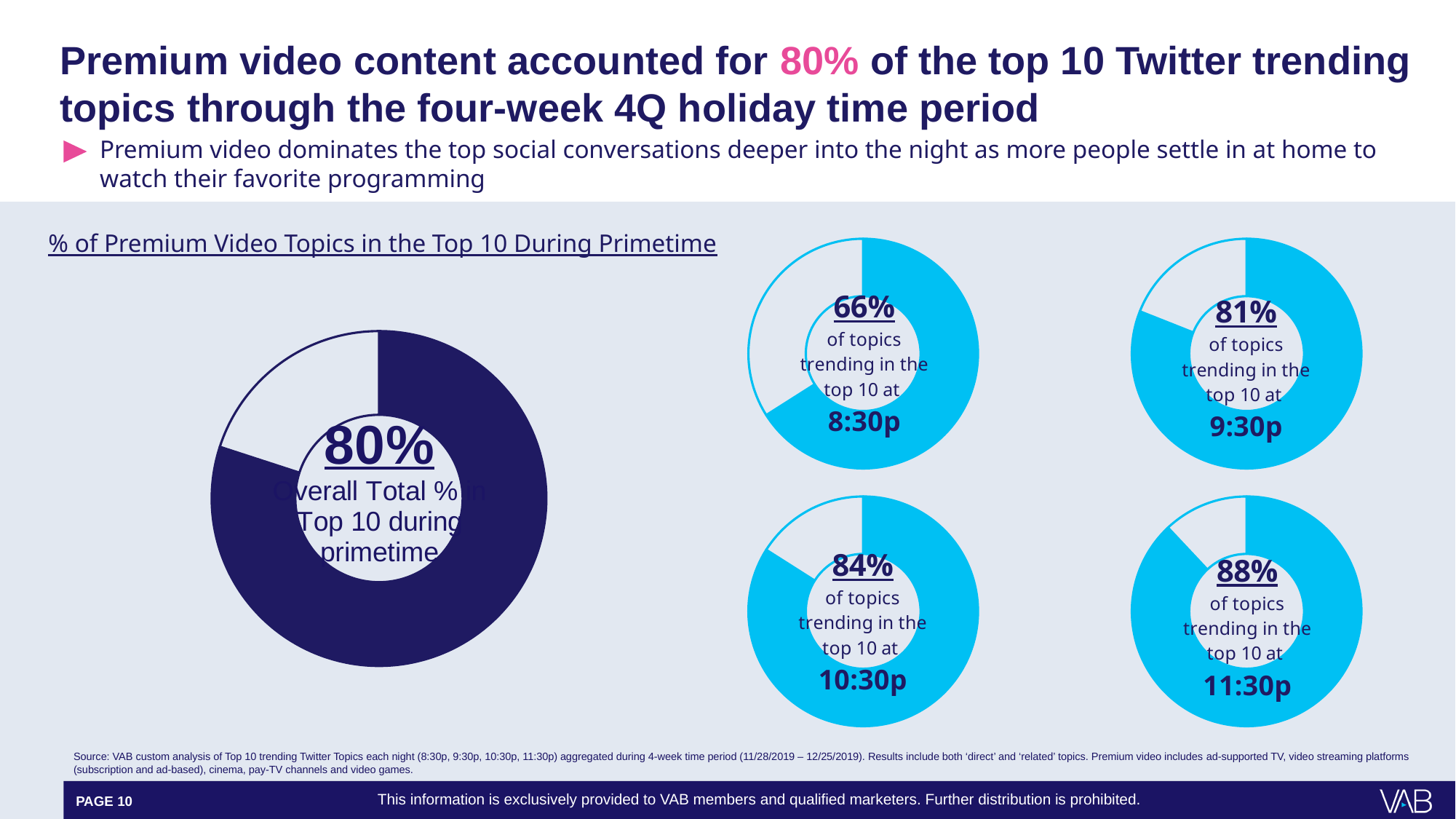
How many small time-slot donut charts are shown on the right side of the slide? 4 What type of chart is used to show the overall total % in the top 10 during primetime? donut (pie) chart In the donut chart for 8:30p, what percentage of topics trending in the top 10 were premium video? 66% What is the difference in percentage points between the 11:30p donut chart and the 8:30p donut chart? 22 In the donut chart for 9:30p, what percentage of topics trending in the top 10 were premium video? 81% Among the four small time-slot donut charts, which time slot has the highest percentage? 11:30p In the donut chart for 11:30p, what percentage of topics trending in the top 10 were premium video? 88% Which is larger: the percentage in the 9:30p donut chart or the 10:30p donut chart? 10:30p What percentage is shown in the large donut chart on the left for the overall total % in the top 10 during primetime? 80% Among the four small time-slot donut charts, which time slot has the lowest percentage? 8:30p In the donut chart for 10:30p, what percentage of topics trending in the top 10 were premium video? 84% Across the four small donut charts, do the percentages rise or fall as the time slot gets later (8:30p to 11:30p)? rise